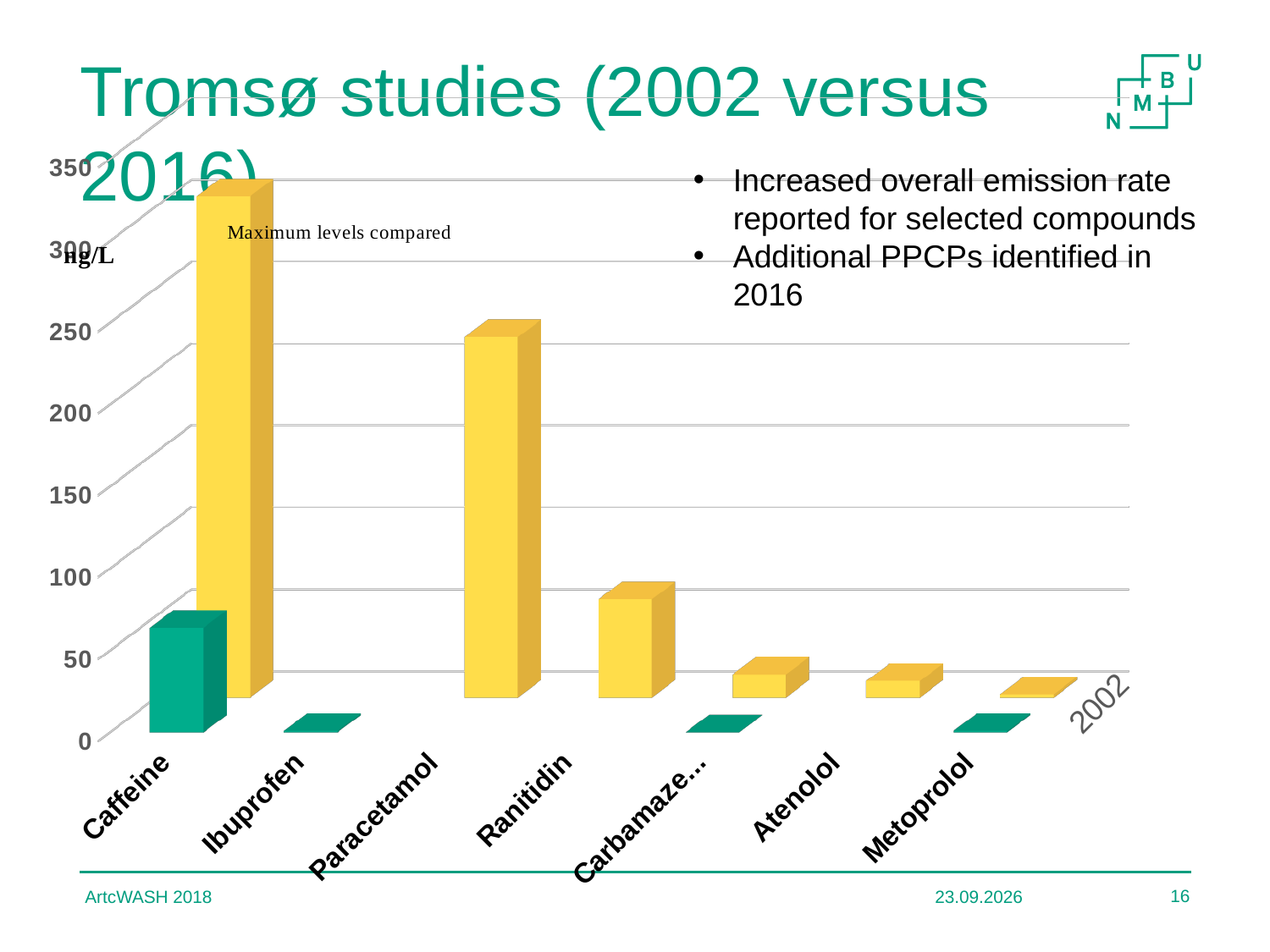
What is the title of the chart? Maximum levels compared Which compound has the highest yellow bar in the chart? Caffeine Is the yellow bar for Caffeine greater or less than 250 ng/L? greater What kind of chart is shown on the slide? bar chart Which has the larger yellow bar, Ranitidin or Atenolol? Ranitidin Is the yellow bar for Paracetamol greater or less than 200 ng/L? greater How many compound categories are shown on the x axis of the chart? 7 Is the green bar for Caffeine greater or less than 100 ng/L? less What unit is shown on the vertical axis of the chart? ng/L Which has the larger yellow bar, Caffeine or Paracetamol? Caffeine